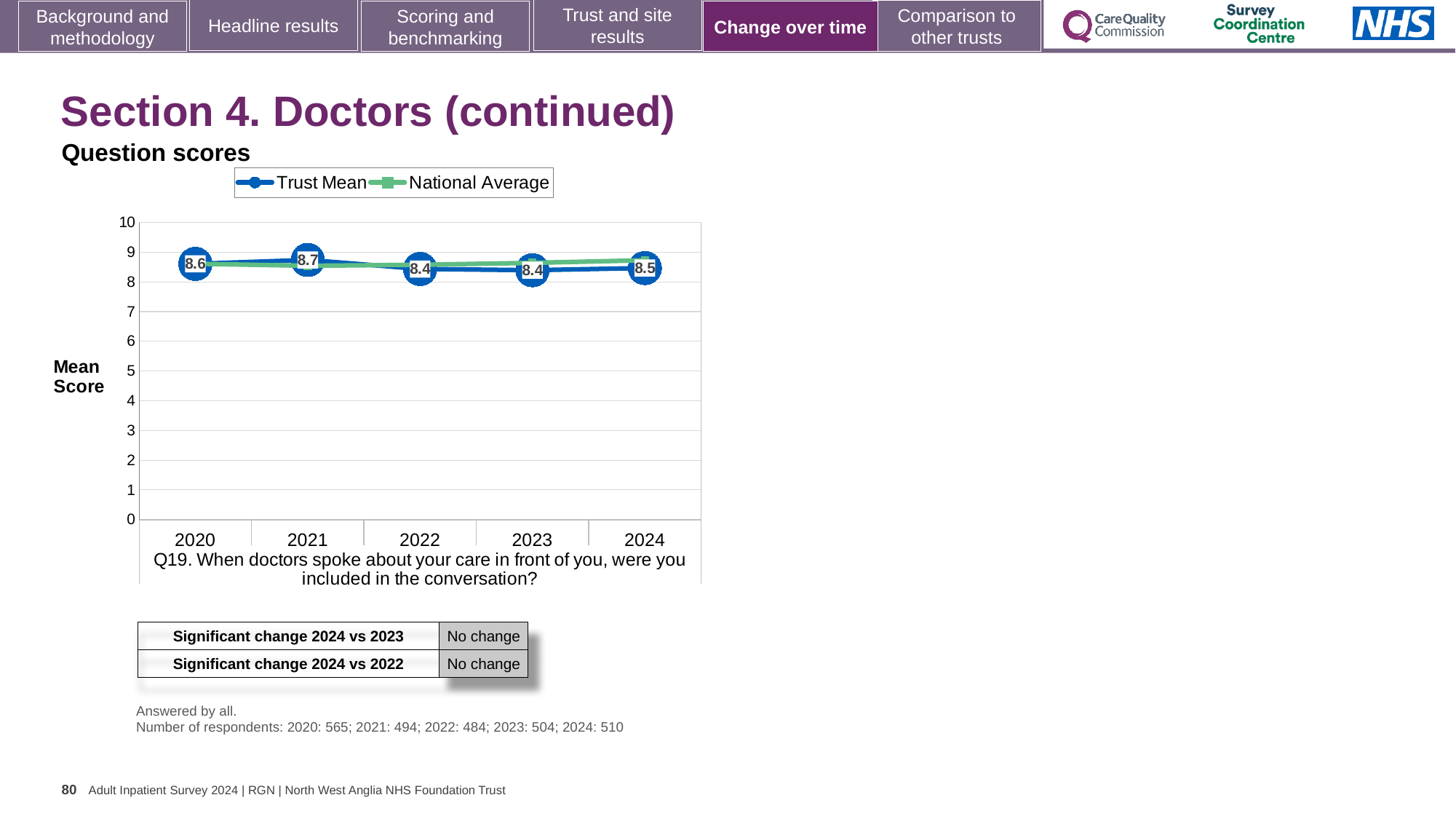
How many series does the chart legend list? 2 What is the Trust Mean score for 2020? 8.6 What kind of chart is shown on the slide? Line chart What is the Trust Mean score for 2021? 8.7 What is the label on the y axis of the chart? Mean Score Is the National Average value for 2024 greater or less than 8? greater What is the Trust Mean score for 2024? 8.5 In which year is the Trust Mean score highest? 2021 Which year has the larger Trust Mean score, 2020 or 2024? 2020 What is the difference between the Trust Mean scores for 2021 and 2022? 0.3 Does the Trust Mean score rise or fall from 2021 to 2022? Fall How many years are plotted on the x axis of the chart? 5